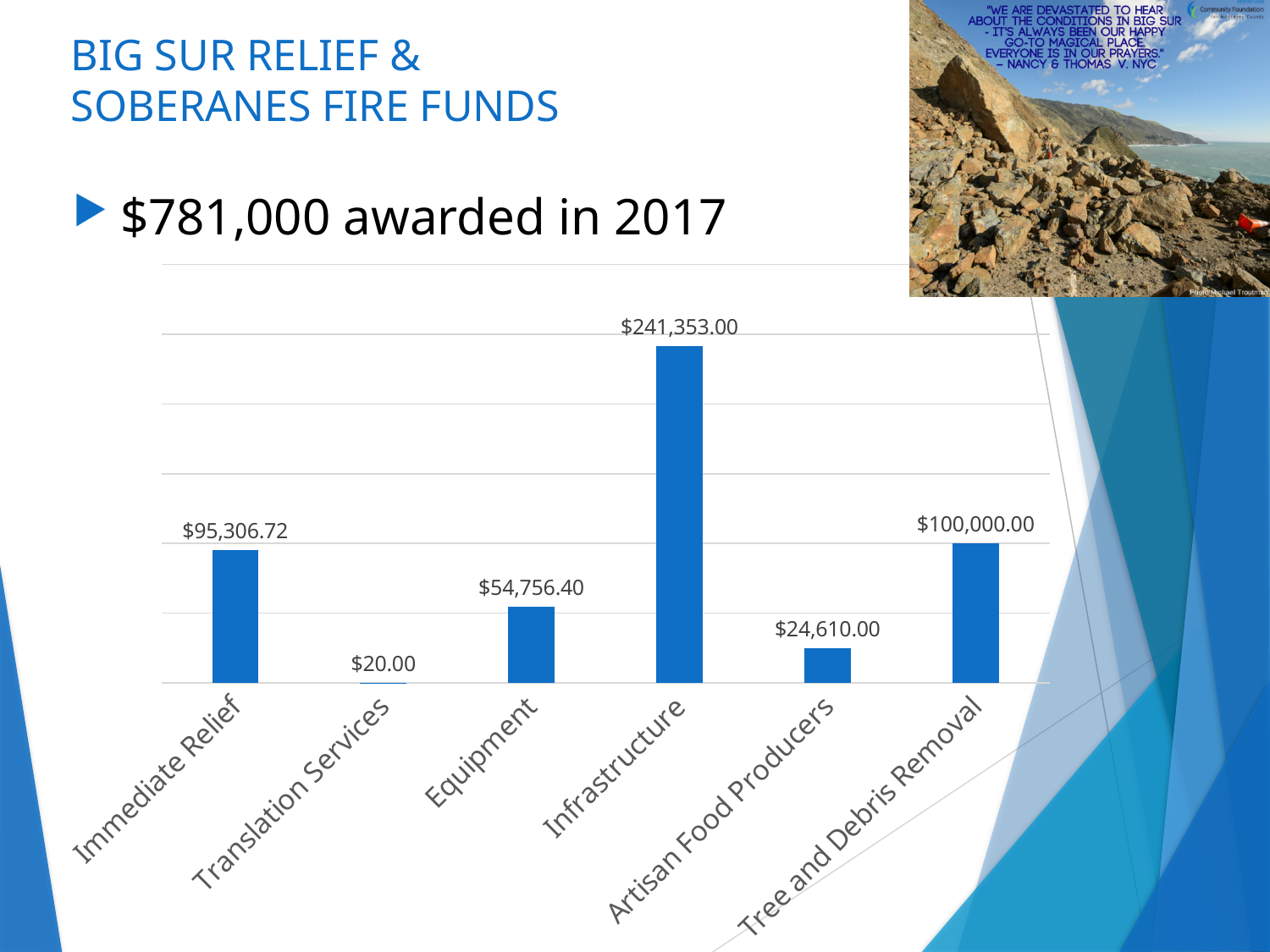
What is the value for Equipment? $54,756.40 Which is larger, Equipment or Tree and Debris Removal? Tree and Debris Removal What is the value for Infrastructure? $241,353.00 Which category has the lowest value? Translation Services What is the value for Immediate Relief? $95,306.72 Which category has the highest value? Infrastructure How many categories are shown in the chart? 6 What is the value for Artisan Food Producers? $24,610.00 What is the value for Translation Services? $20.00 What is the difference between Equipment and Artisan Food Producers? $30,146.40 What kind of chart is shown on the slide? Bar chart What is the difference between Tree and Debris Removal and Immediate Relief? $4,693.28